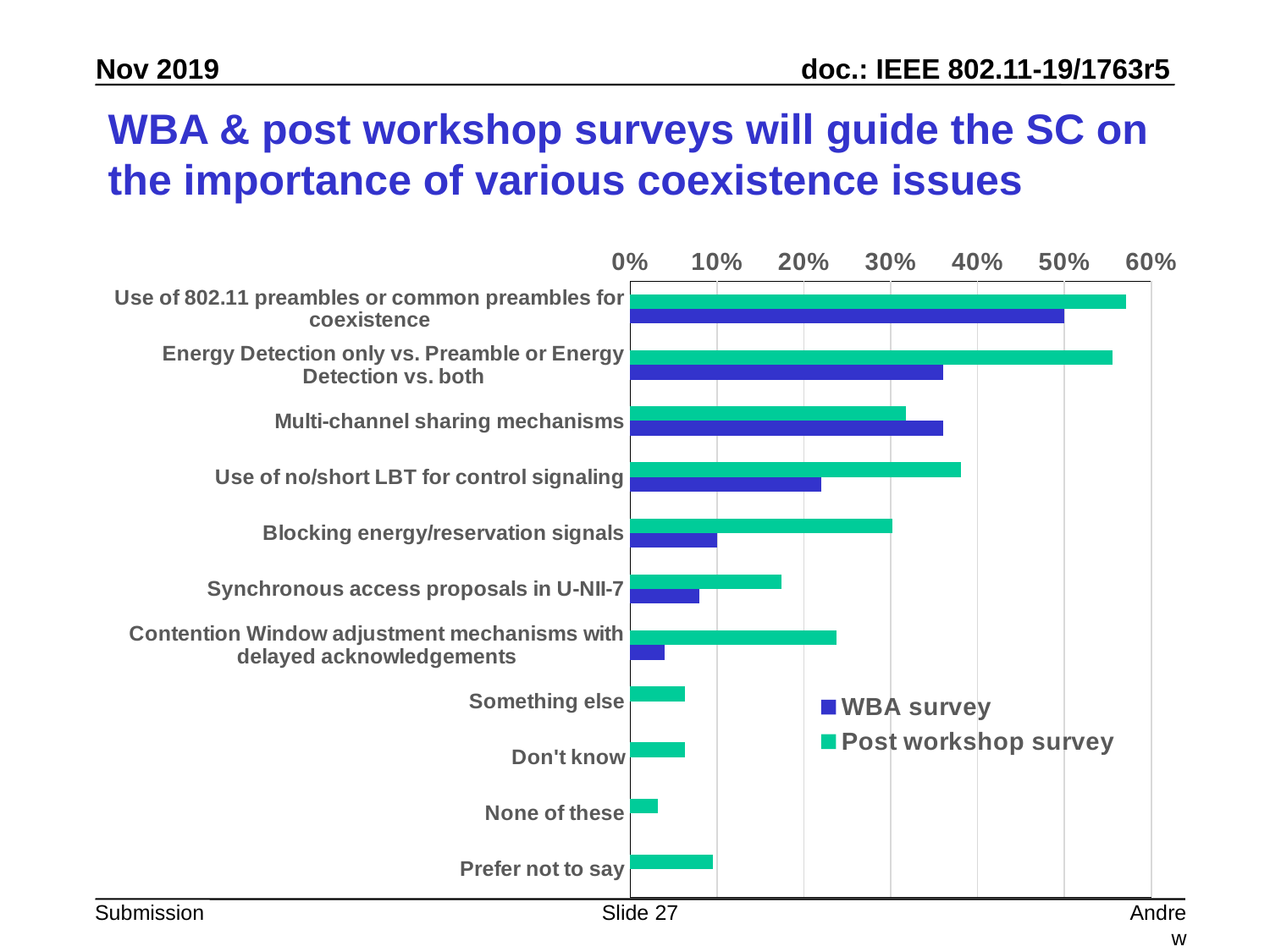
Is the WBA survey value for Use of no/short LBT for control signaling greater or less than 30%? less Which series has a bar for the category Prefer not to say? Post workshop survey What colour represents the WBA survey series in the legend? blue For Multi-channel sharing mechanisms, which series has the larger value, WBA survey or Post workshop survey? WBA survey Is the Post workshop survey value for Contention Window adjustment mechanisms with delayed acknowledgements greater or less than 20%? greater What kind of chart is shown on the slide? bar chart How many categories are shown on the chart? 11 For Blocking energy/reservation signals, which series has the larger value, WBA survey or Post workshop survey? Post workshop survey Which category has the lowest value for the Post workshop survey series? None of these How many series does the legend list? 2 Is the Post workshop survey value for Energy Detection only vs. Preamble or Energy Detection vs. both greater or less than 50%? greater Which category has the highest value for the WBA survey series? Use of 802.11 preambles or common preambles for coexistence